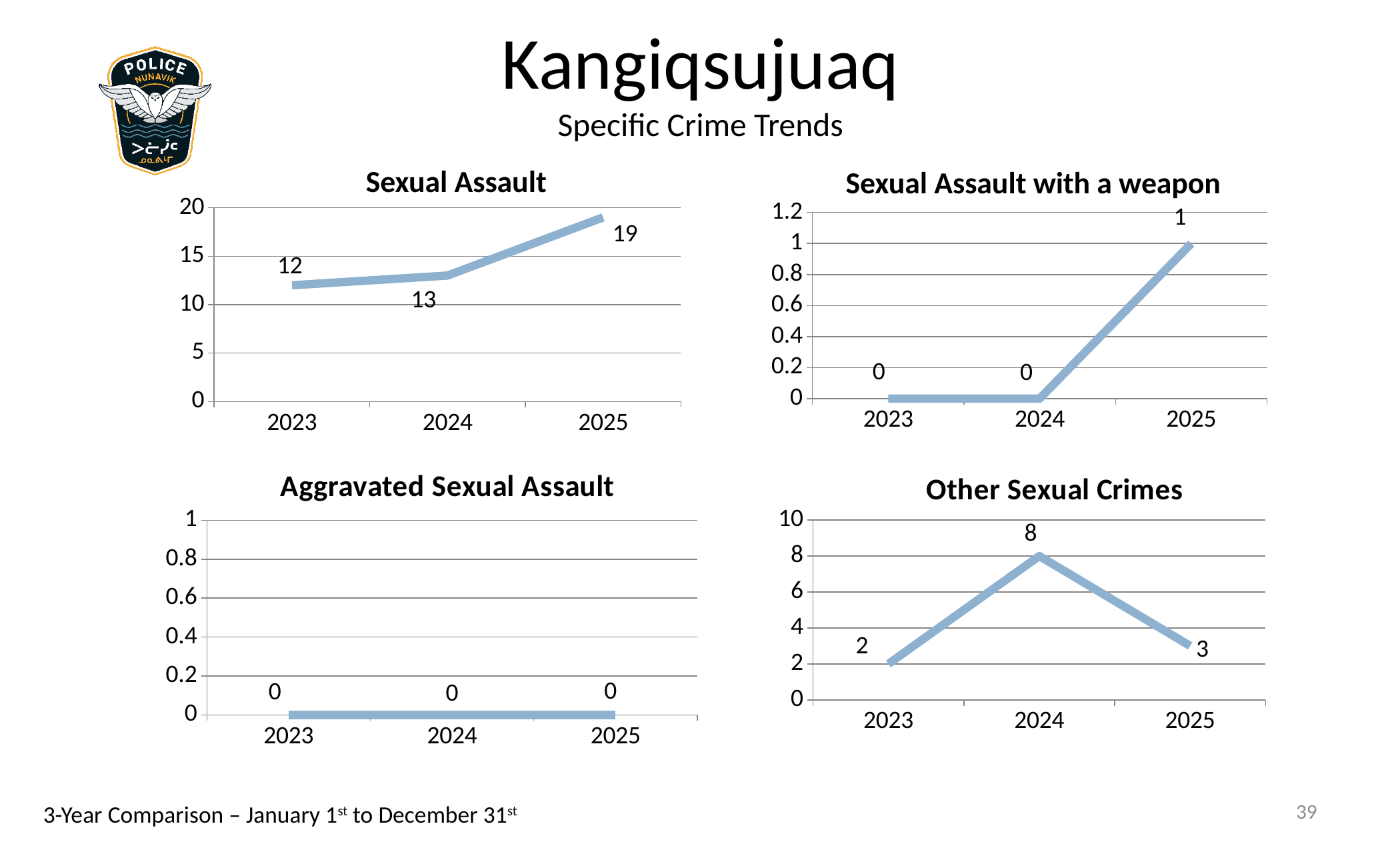
In the 'Sexual Assault with a weapon' chart, what is the value for 2024? 0 What kind of chart is the 'Other Sexual Crimes' chart? line chart In the 'Sexual Assault' chart, what is the value for 2023? 12 In the 'Aggravated Sexual Assault' chart, what is the value for 2024? 0 In the 'Other Sexual Crimes' chart, which is larger, the value for 2023 or the value for 2025? 2025 In the 'Sexual Assault with a weapon' chart, what is the value for 2025? 1 In the 'Sexual Assault' chart, do the values rise or fall from 2023 to 2025? rise In the 'Other Sexual Crimes' chart, which year has the highest value? 2024 In the 'Sexual Assault' chart, which year has the highest value? 2025 In the 'Sexual Assault' chart, what is the value for 2025? 19 In the 'Sexual Assault' chart, what is the difference between the 2025 and 2024 values? 6 In the 'Other Sexual Crimes' chart, what is the difference between the 2024 and 2023 values? 6